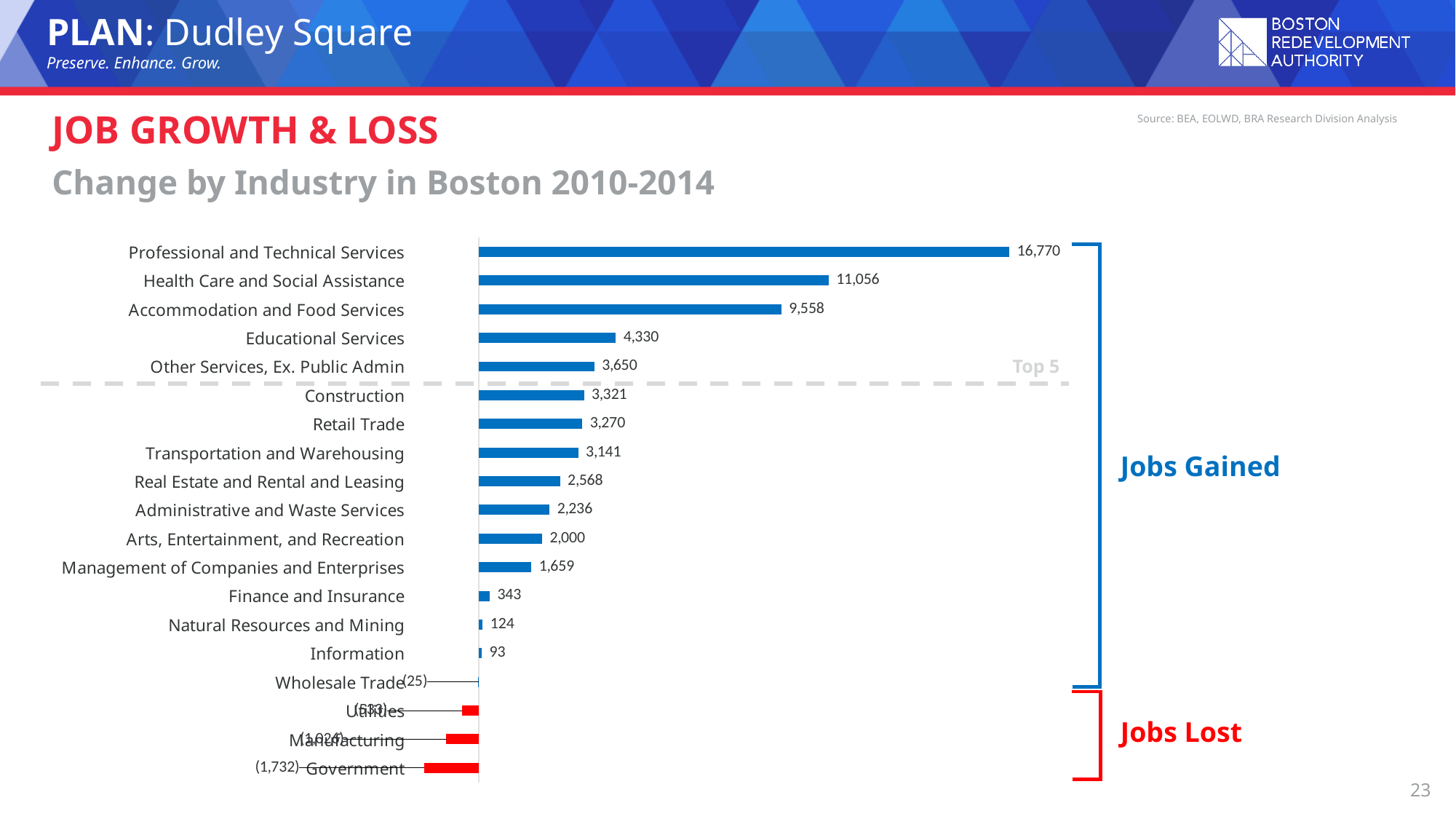
Which industry has the highest job gain? Professional and Technical Services What is the value shown for Health Care and Social Assistance? 11,056 What is the job change value for Professional and Technical Services? 16,770 What is the value shown for Wholesale Trade? (25) What colour are the bars for industries that lost jobs? red How many industries are shown in the chart? 19 What kind of chart is shown on the slide? bar chart What is the difference between the values for Professional and Technical Services and Health Care and Social Assistance? 5,714 What is the value shown for Educational Services? 4,330 What is the value shown for Government? (1,732) Which is larger, the value for Construction or the value for Retail Trade? Construction Which industry has the largest job loss? Government